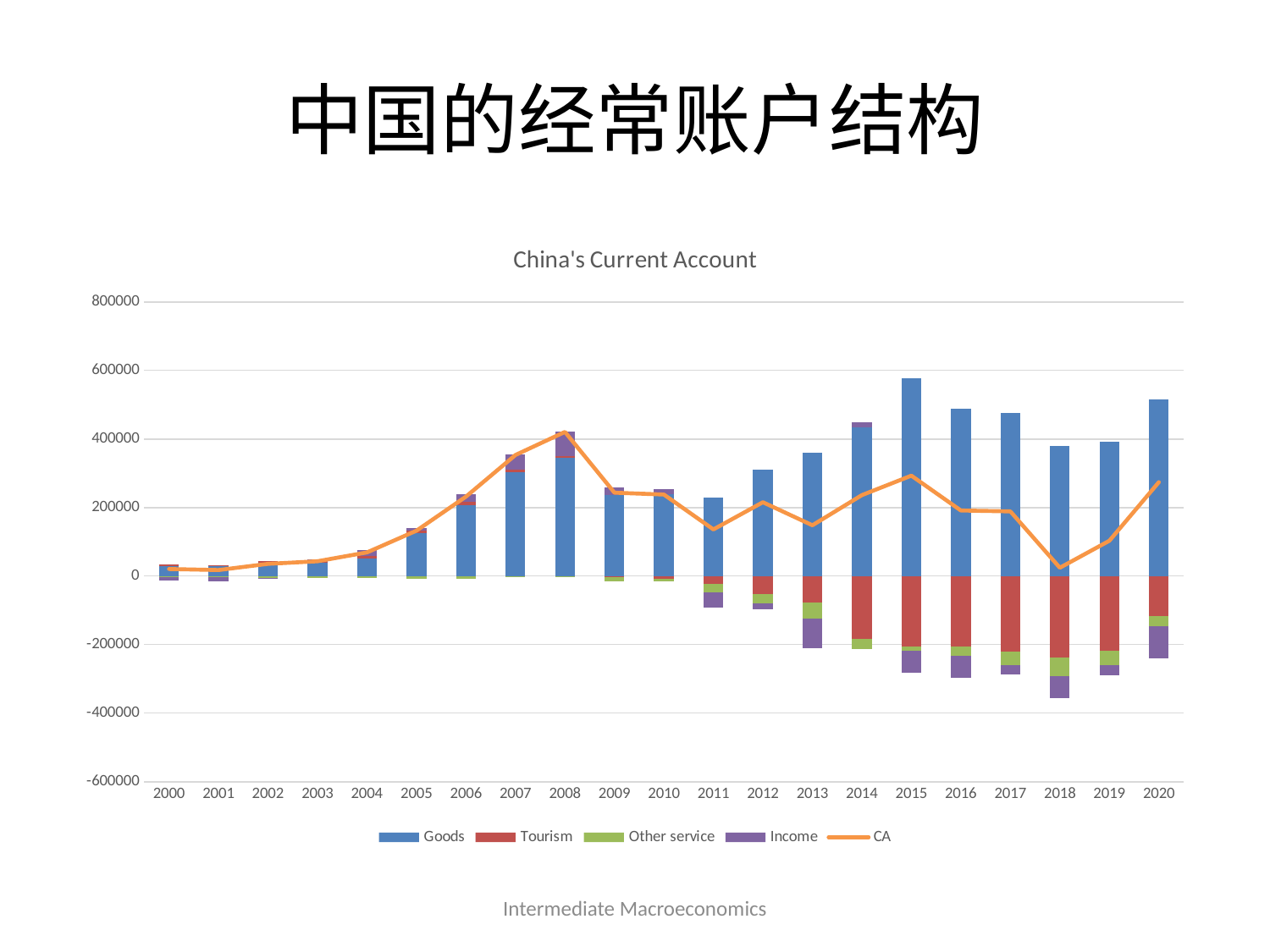
What kind of chart is shown on the slide? A stacked bar chart with a line In which year is the Goods bar the tallest? 2015 Is the Goods value for 2008 greater or less than 200000? greater How many series does the legend list? 5 Which series is drawn as a line rather than bars? CA How many years are shown on the x axis? 21 Is the CA value for 2018 greater or less than 200000? less Is the Goods value for 2015 greater or less than 400000? greater Does the CA line rise or fall from 2015 to 2018? fall Between 2011 and 2020, in which year is the CA line at its lowest? 2018 What is the title of the chart? China's Current Account Which is larger, the Goods value for 2015 or for 2016? 2015